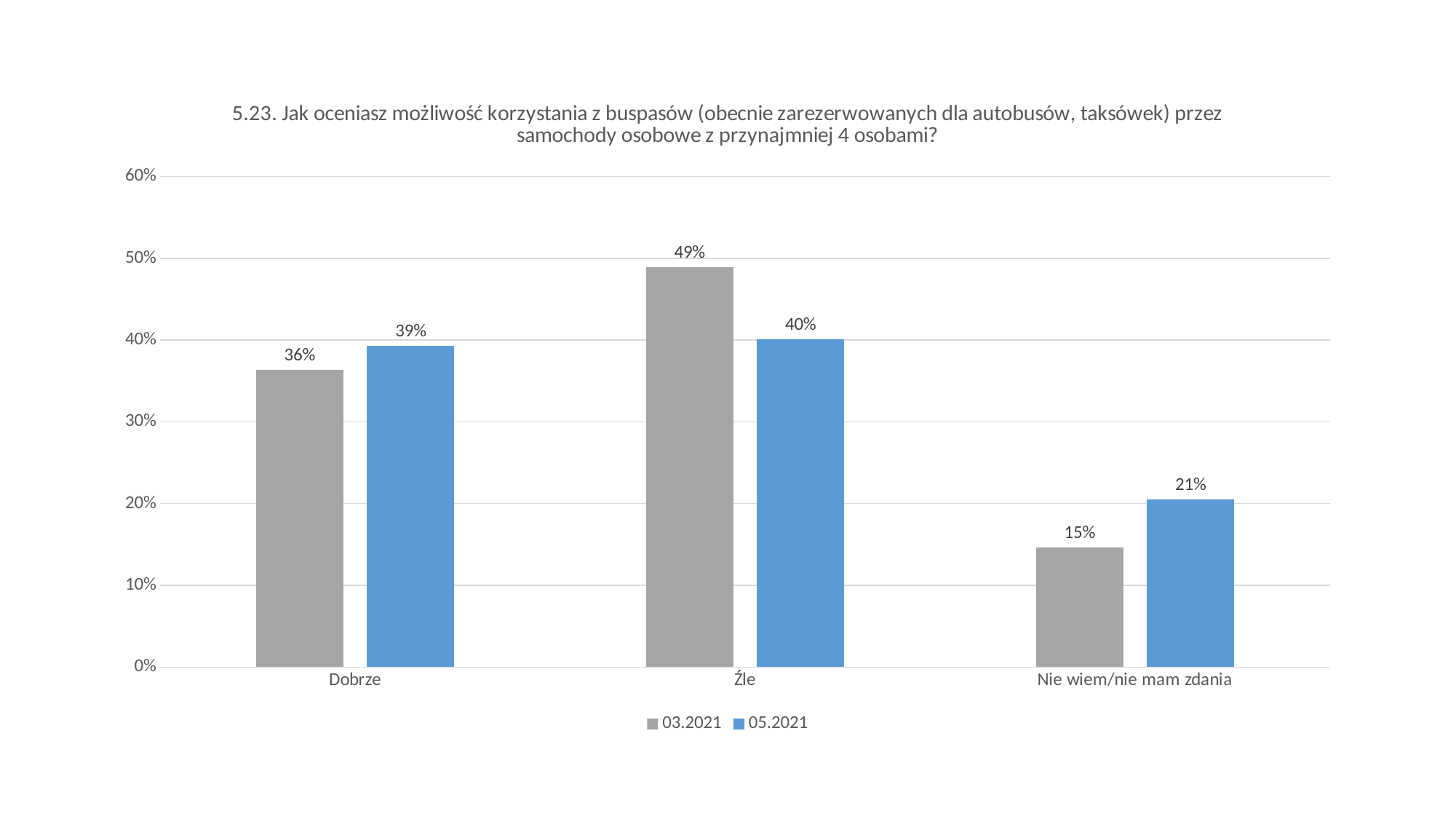
What is the value for "Źle" in the 05.2021 series? 40% What is the difference between the 03.2021 and 05.2021 values for "Źle"? 9% What is the value for "Dobrze" in the 03.2021 series? 36% Which category has the highest value in the 03.2021 series? Źle How many categories are shown on the x axis? 3 Which is larger for "Dobrze": the 03.2021 value or the 05.2021 value? 05.2021 What is the value for "Nie wiem/nie mam zdania" in the 03.2021 series? 15% What kind of chart is shown on the slide? bar chart Is the 05.2021 value for "Nie wiem/nie mam zdania" greater or less than 30%? less What colour are the bars for the 05.2021 series? blue How many series does the legend list? 2 Which category has the lowest value in the 05.2021 series? Nie wiem/nie mam zdania